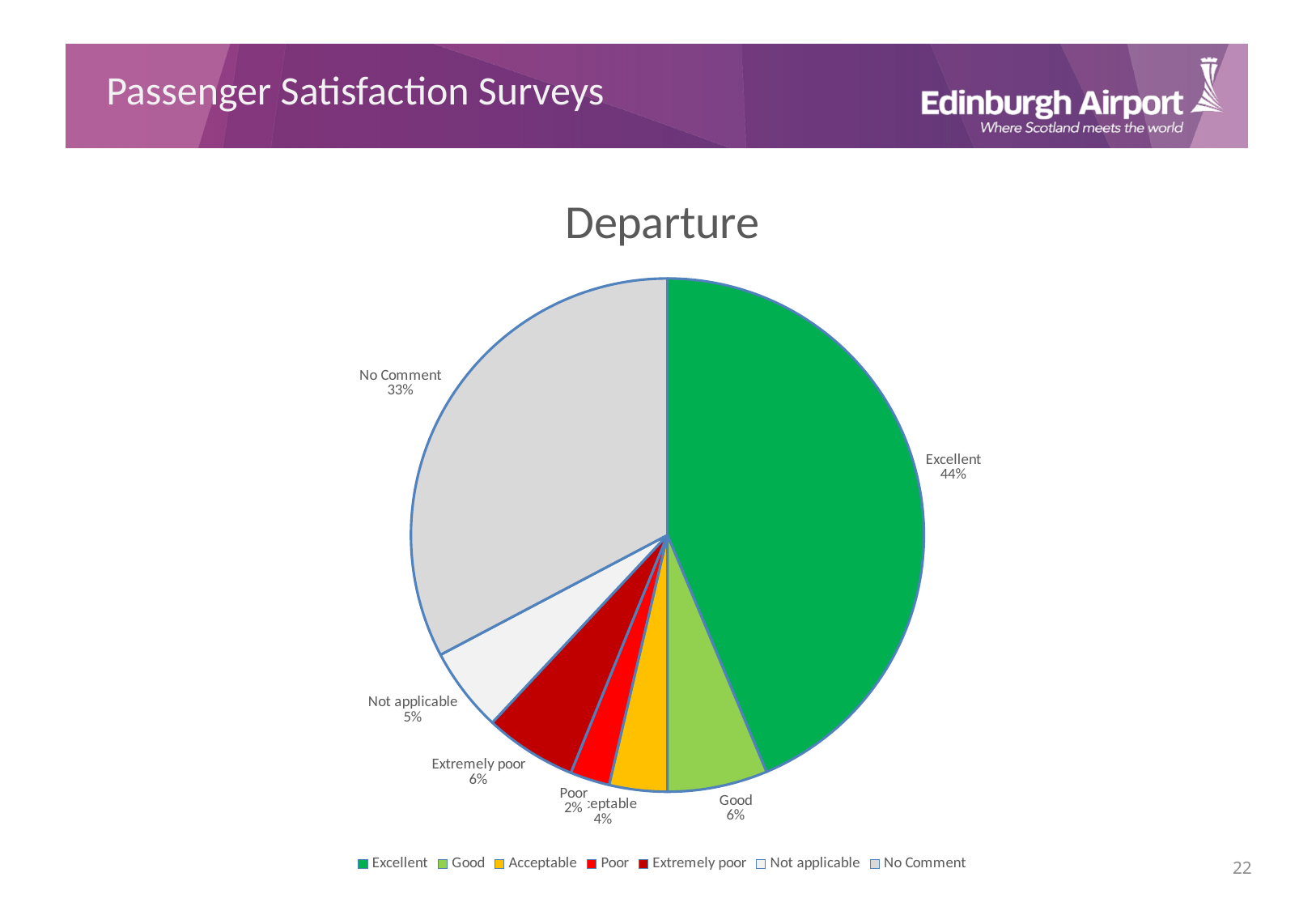
What type of chart is shown on the slide? pie chart What percentage of the pie is labelled No Comment? 33% How many categories does the legend list? 7 Which category has the smallest share of the pie? Poor What percentage of the pie is labelled Not applicable? 5% What percentage of the pie is labelled Excellent? 44% What is the title of the chart? Departure Which category has the largest share of the pie? Excellent What percentage of the pie is labelled Poor? 2% Which is larger, the share for Not applicable or the share for Good? Good What percentage of the pie is labelled Extremely poor? 6% What is the difference in percentage points between Excellent and No Comment? 11